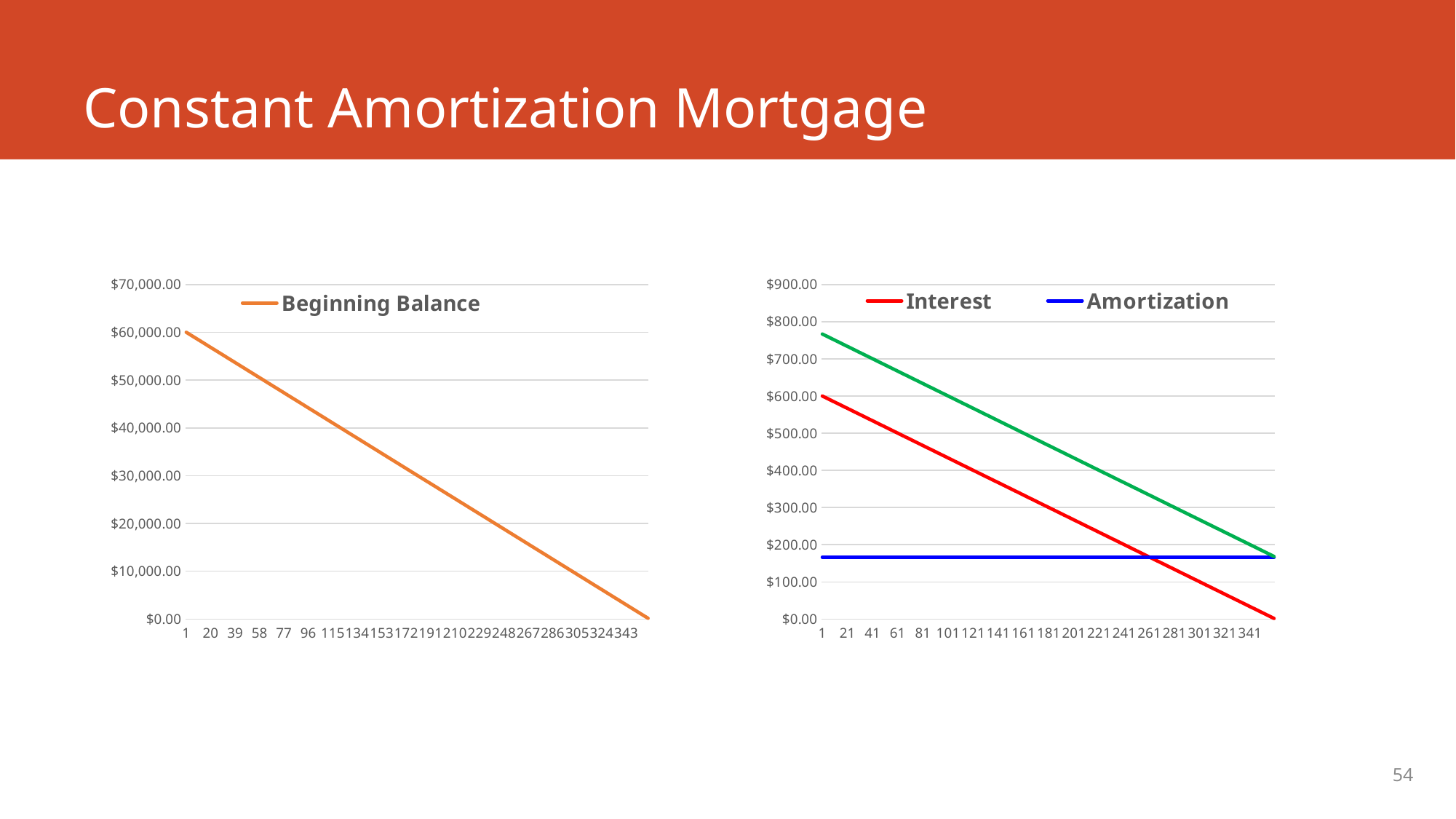
In the right chart, which is larger at period 341, Interest or Amortization? Amortization In the left chart, is the Beginning Balance at period 191 greater or less than $40,000.00? less In the left chart, is the Beginning Balance at period 96 greater or less than $40,000.00? greater In the right chart, which is larger at period 1, Interest or Amortization? Interest In the left chart, does the Beginning Balance rise or fall along the x axis? fall What colour is the Interest line in the right chart? red How many series does the legend of the right chart list? 2 What type of chart is the left chart showing Beginning Balance? line chart In the right chart, does the Interest line rise or fall along the x axis? fall In the right chart, what is the Interest value at period 1? $600.00 In the left chart, what is the Beginning Balance at period 1? $60,000.00 In the right chart, is the Amortization value greater or less than $200.00? less